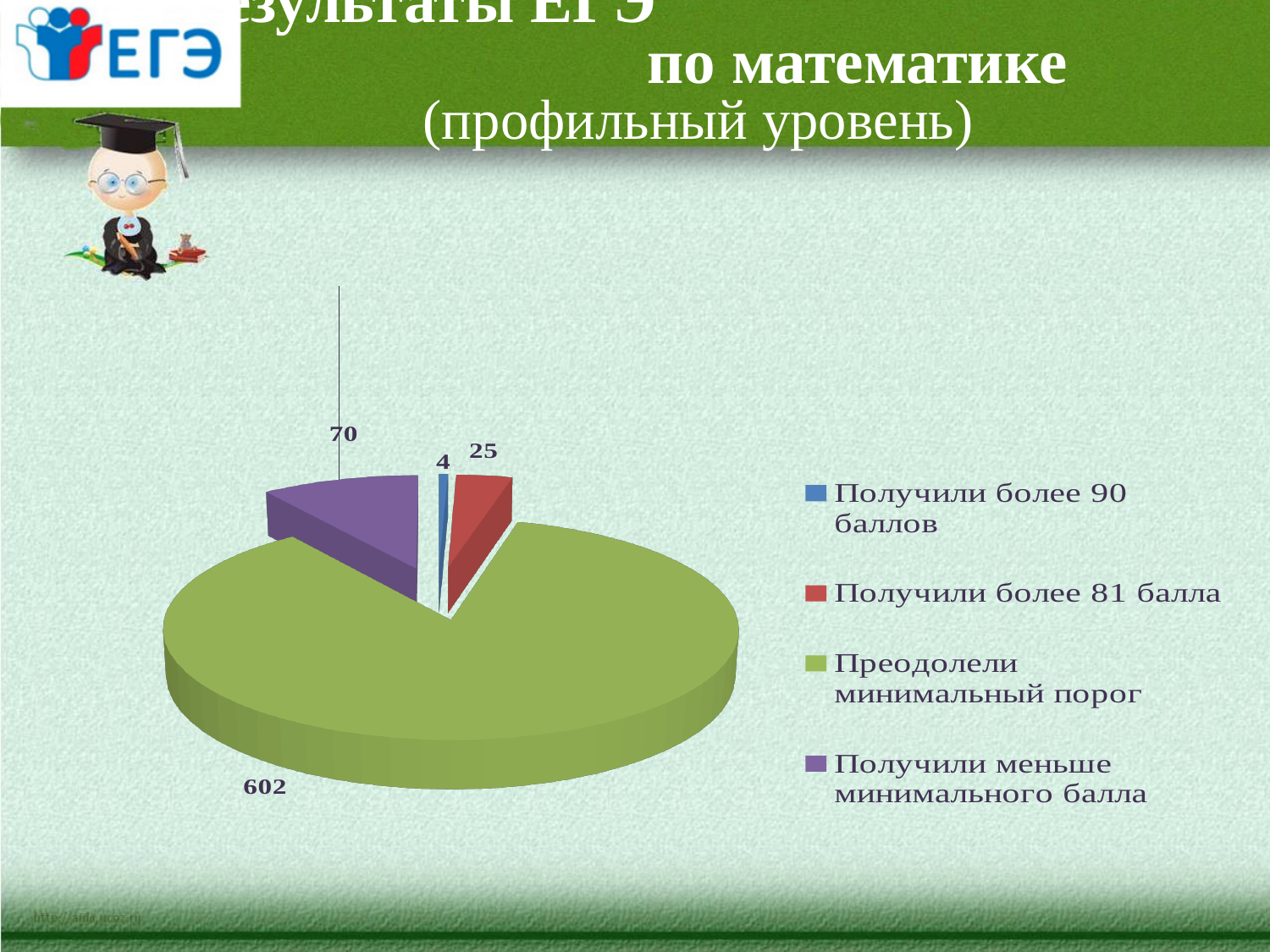
What is the value for "Получили более 90 баллов"? 4 Which category has the largest slice? Преодолели минимальный порог Which category has the smallest slice? Получили более 90 баллов What kind of chart is shown on the slide? pie chart How many entries does the legend list? 4 What is the value for "Преодолели минимальный порог"? 602 What is the value for "Получили меньше минимального балла"? 70 What is the difference between the values for "Получили меньше минимального балла" and "Получили более 81 балла"? 45 What is the value for "Получили более 81 балла"? 25 How many slices does the pie chart have? 4 Which is larger: the value for "Получили более 81 балла" or the value for "Получили более 90 баллов"? Получили более 81 балла What colour is the slice for "Преодолели минимальный порог"? green